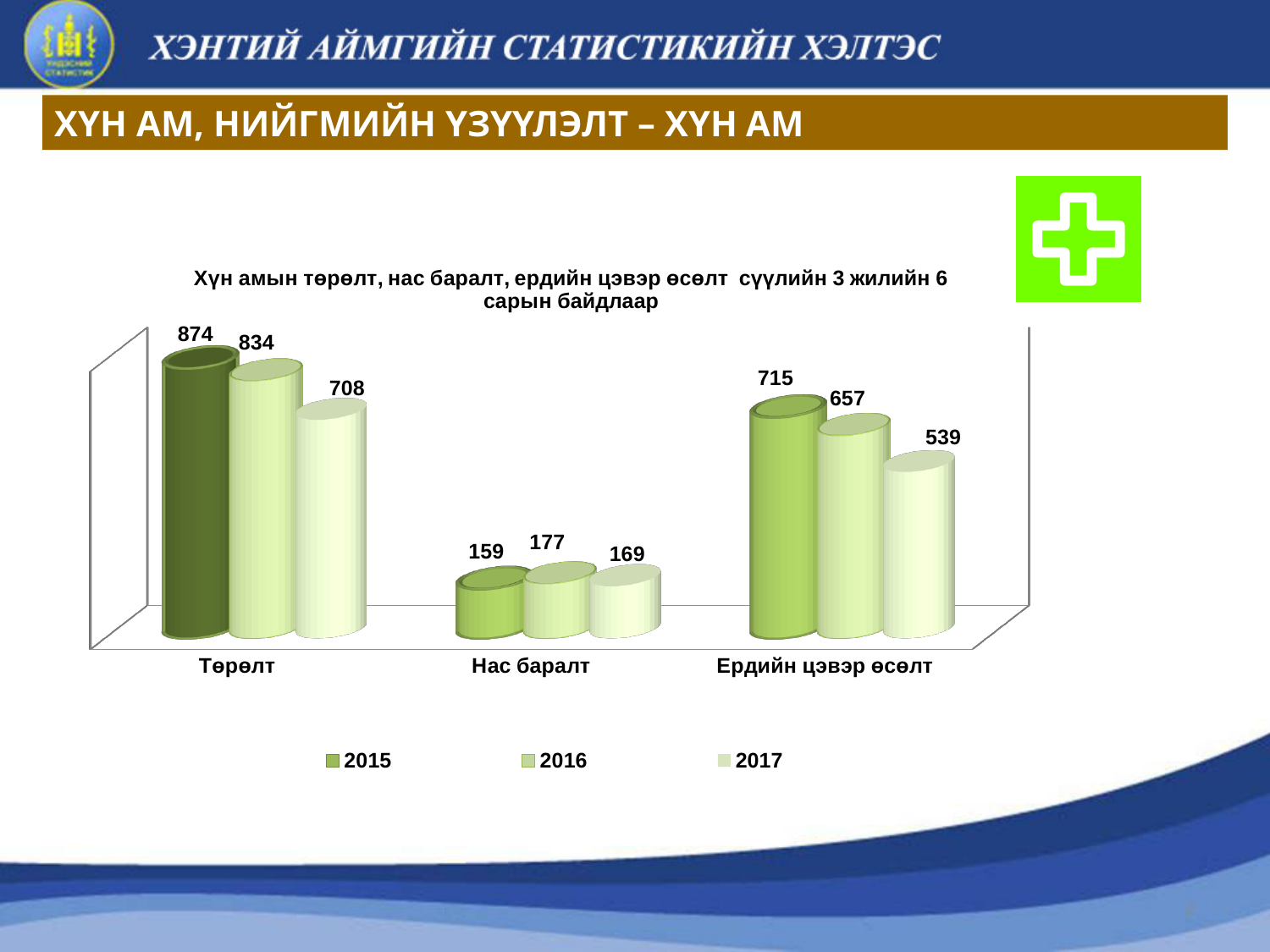
What is the difference between the 2015 and 2016 values for Ердийн цэвэр өсөлт? 58 Which category has the highest value in 2015? Төрөлт What is the value for Нас баралт in 2016? 177 Do the values for Ердийн цэвэр өсөлт rise or fall from 2015 to 2017? Fall How many categories are shown on the x axis? 3 Which is larger: the 2016 value for Нас баралт or the 2017 value for Нас баралт? 2016 How many series does the legend list? 3 What is the value for Ердийн цэвэр өсөлт in 2017? 539 What is the difference between the 2015 and 2017 values for Төрөлт? 166 What kind of chart is shown on the slide? Bar chart What is the value for Төрөлт in 2015? 874 Which category has the lowest value in 2017? Нас баралт